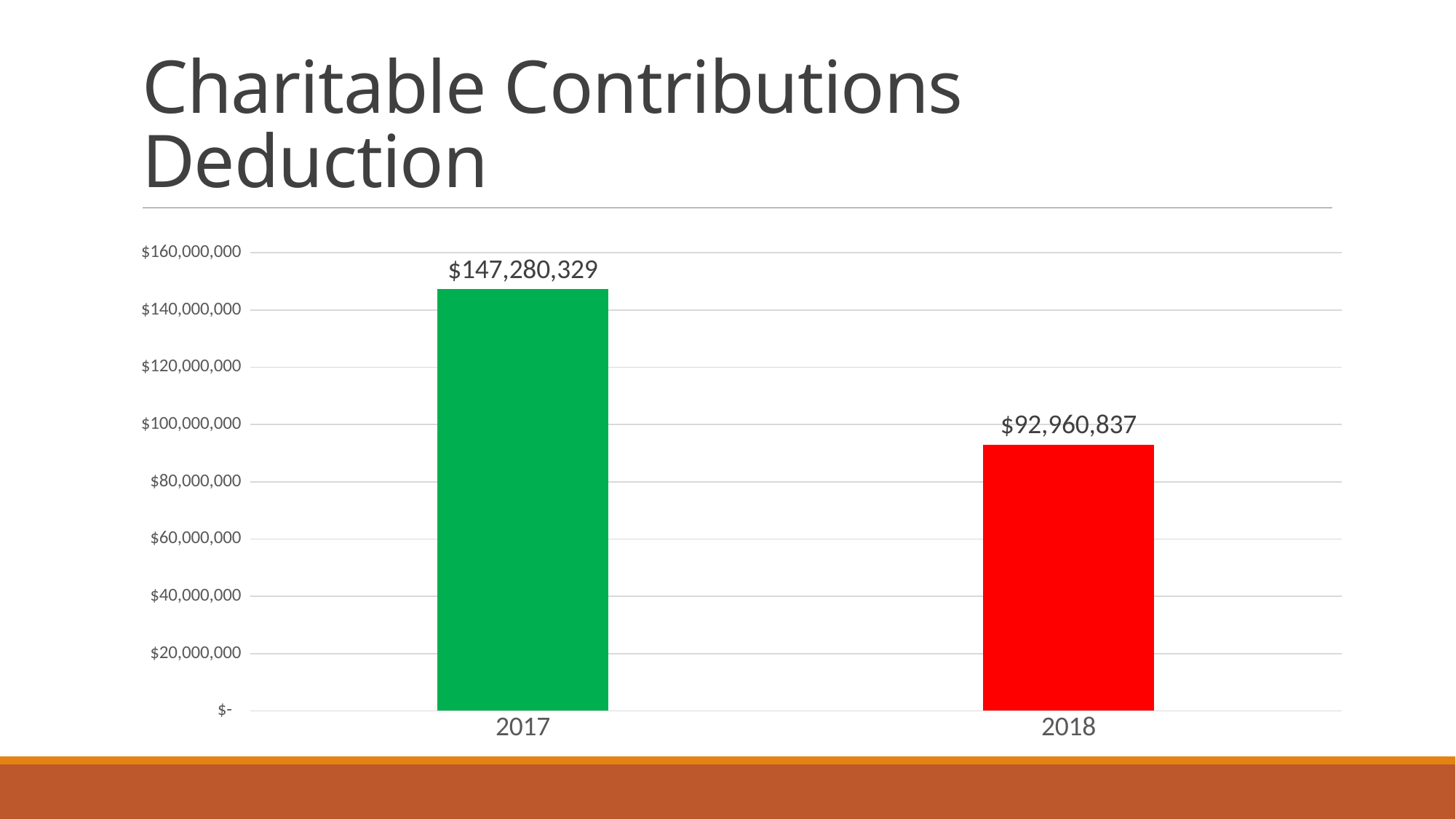
Do the values rise or fall from 2017 to 2018? fall Which year has the highest value? 2017 Is the value for 2017 greater or less than $140,000,000? greater How many years are shown on the x axis? 2 Which year has the lowest value? 2018 Which is larger, the value for 2017 or the value for 2018? 2017 What is the value for 2017? $147,280,329 What colour is the bar for 2018? red What kind of chart is shown on the slide? bar chart What is the value for 2018? $92,960,837 What is the difference between the 2017 and 2018 values? $54,319,492 Is the value for 2018 greater or less than $100,000,000? less